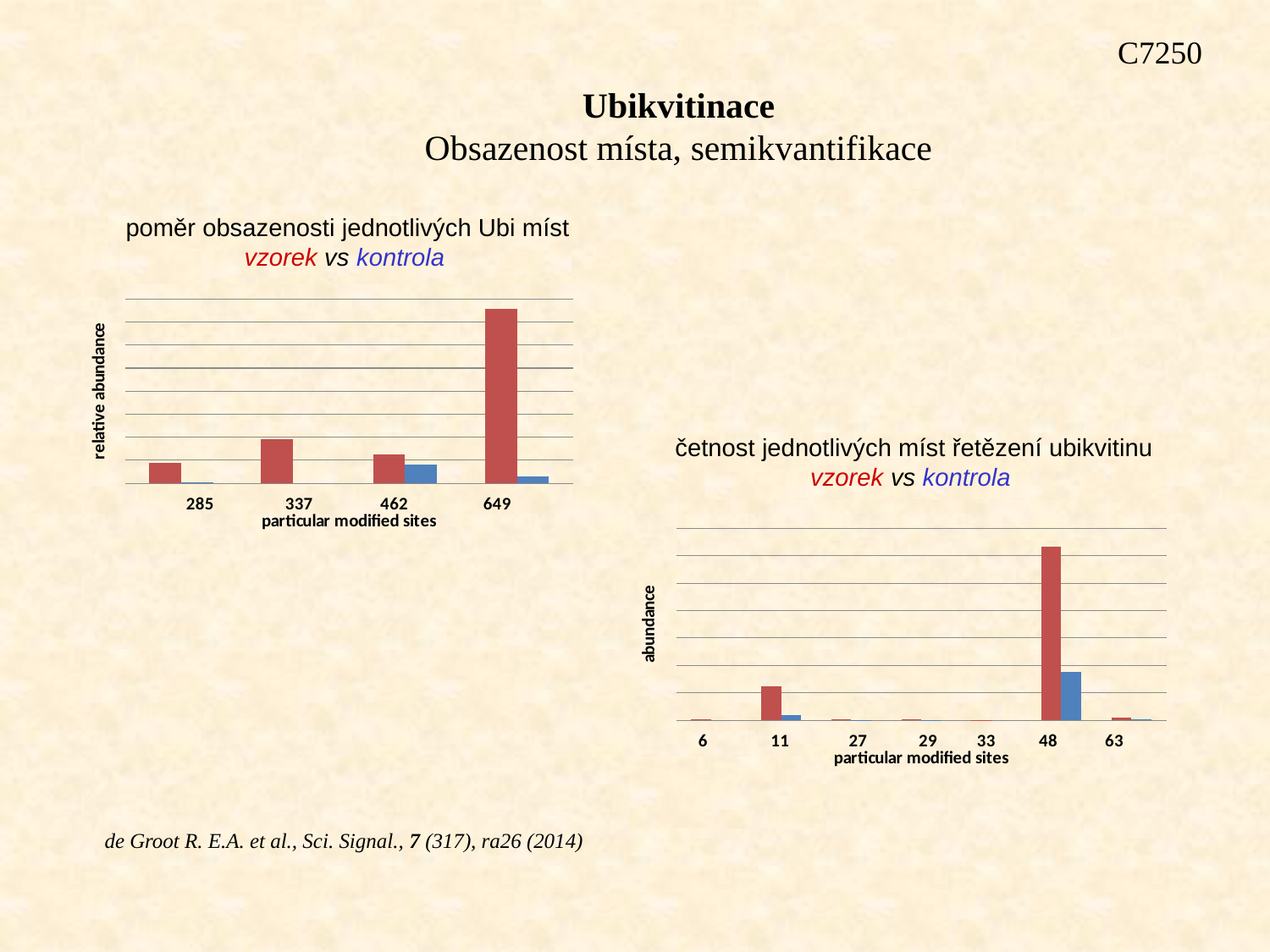
In the left chart (poměr obsazenosti jednotlivých Ubi míst), which modified site has the highest red (vzorek) bar? 649 What is the x-axis label of the right chart (četnost jednotlivých míst řetězení ubikvitinu)? particular modified sites In the right chart (četnost jednotlivých míst řetězení ubikvitinu), which modified site has the highest red (vzorek) bar? 48 In the left chart (poměr obsazenosti jednotlivých Ubi míst), which modified site has the highest blue (kontrola) bar? 462 What is the y-axis label of the left chart (poměr obsazenosti jednotlivých Ubi míst)? relative abundance In the left chart (poměr obsazenosti jednotlivých Ubi míst), is the red bar for site 337 larger or smaller than the red bar for site 462? larger What kind of chart is the right chart titled 'četnost jednotlivých míst řetězení ubikvitinu'? bar chart In the right chart (četnost jednotlivých míst řetězení ubikvitinu), is the red bar for site 11 larger or smaller than the red bar for site 63? larger In the right chart (četnost jednotlivých míst řetězení ubikvitinu), how many modified sites are shown on the x axis? 7 What kind of chart is the left chart titled 'poměr obsazenosti jednotlivých Ubi míst'? bar chart In the left chart (poměr obsazenosti jednotlivých Ubi míst), how many modified sites are shown on the x axis? 4